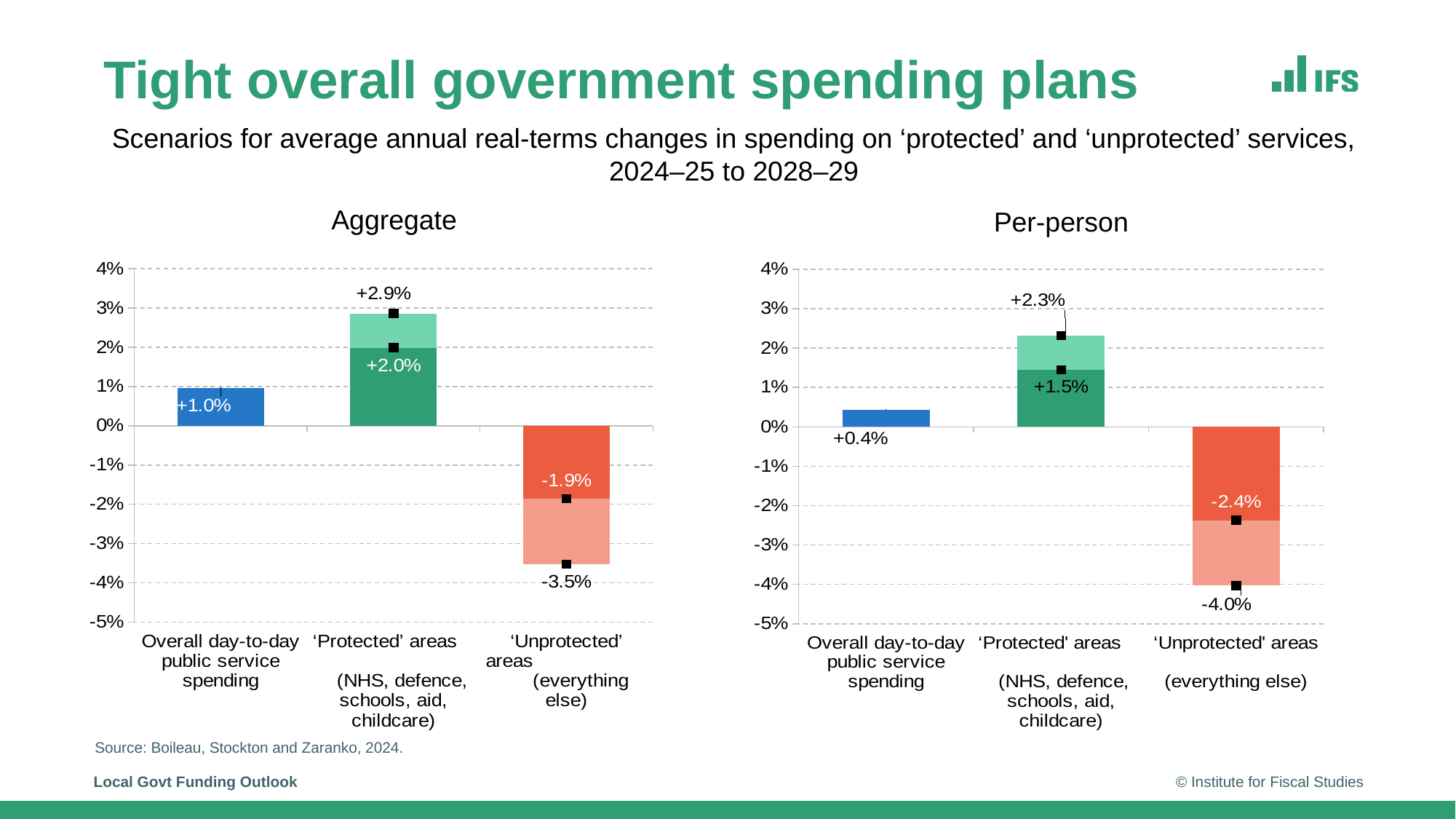
In the Per-person chart, what is the lowest value shown for 'Unprotected' areas? -4.0% In the Aggregate chart, what is the value shown for overall day-to-day public service spending? +1.0% What is the title of the chart on the left of the slide? Aggregate Which is larger: the overall day-to-day public service spending value in the Aggregate chart or in the Per-person chart? Aggregate (+1.0%) In the Aggregate chart, what is the higher of the two values shown for 'Protected' areas? +2.9% In the Aggregate chart, what is the lowest value shown for 'Unprotected' areas? -3.5% What type of chart is the Per-person chart? Bar chart In the Aggregate chart, what is the difference between the two values shown for 'Unprotected' areas (-1.9% and -3.5%)? 1.6 percentage points In the Per-person chart, what is the value shown for overall day-to-day public service spending? +0.4% How many categories are shown on the x axis of the Aggregate chart? 3 In the Per-person chart, what is the lower of the two values shown for 'Protected' areas? +1.5% In the Per-person chart, what is the difference between the two values shown for 'Protected' areas (+2.3% and +1.5%)? 0.8 percentage points